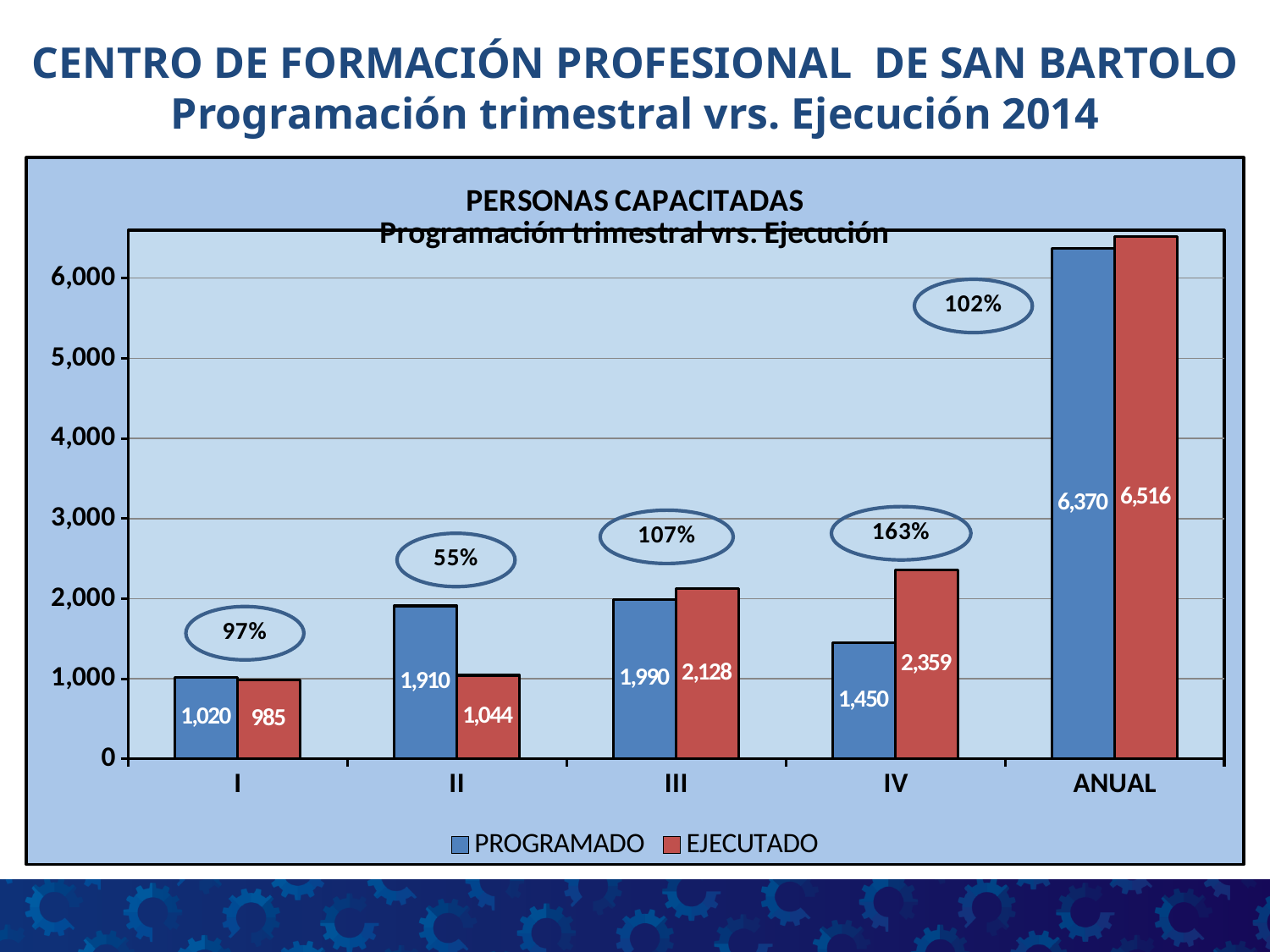
What is the PROGRAMADO value for quarter II? 1,910 For quarter I, which is larger, PROGRAMADO or EJECUTADO? PROGRAMADO For quarter III, which is larger, PROGRAMADO or EJECUTADO? EJECUTADO What is the EJECUTADO value for ANUAL? 6,516 How many categories are shown on the x axis? 5 What is the EJECUTADO value for quarter IV? 2,359 Which category has the highest PROGRAMADO value? ANUAL What type of chart is shown? Bar chart Which quarter (I to IV) has the lowest EJECUTADO value? I How many series does the legend list? 2 What is the difference between the PROGRAMADO and EJECUTADO values for quarter II? 866 What is the difference between the EJECUTADO and PROGRAMADO values for quarter IV? 909